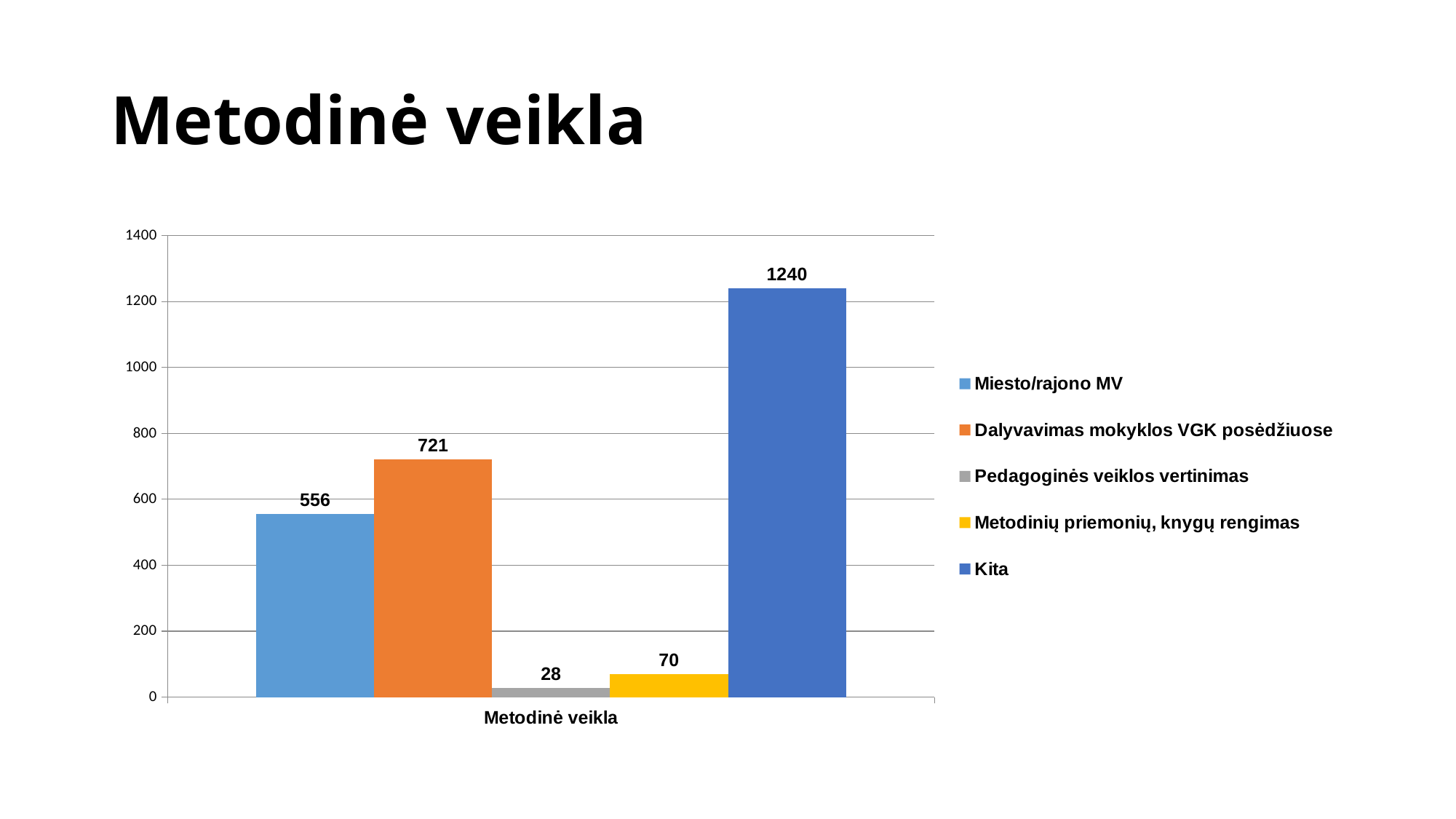
What is the value for Pedagoginės veiklos vertinimas? 28 What is the category label shown on the x axis? Metodinė veikla Which series has the highest value? Kita What is the value for Dalyvavimas mokyklos VGK posėdžiuose? 721 Which series has the lowest value? Pedagoginės veiklos vertinimas Which is larger, the value for Miesto/rajono MV or the value for Dalyvavimas mokyklos VGK posėdžiuose? Dalyvavimas mokyklos VGK posėdžiuose What is the difference between the values for Kita and Dalyvavimas mokyklos VGK posėdžiuose? 519 How many series does the legend list? 5 What kind of chart is shown on the slide? bar chart Is the value for Kita greater or less than 1200? greater What is the value for Metodinių priemonių, knygų rengimas? 70 What is the value for Miesto/rajono MV? 556